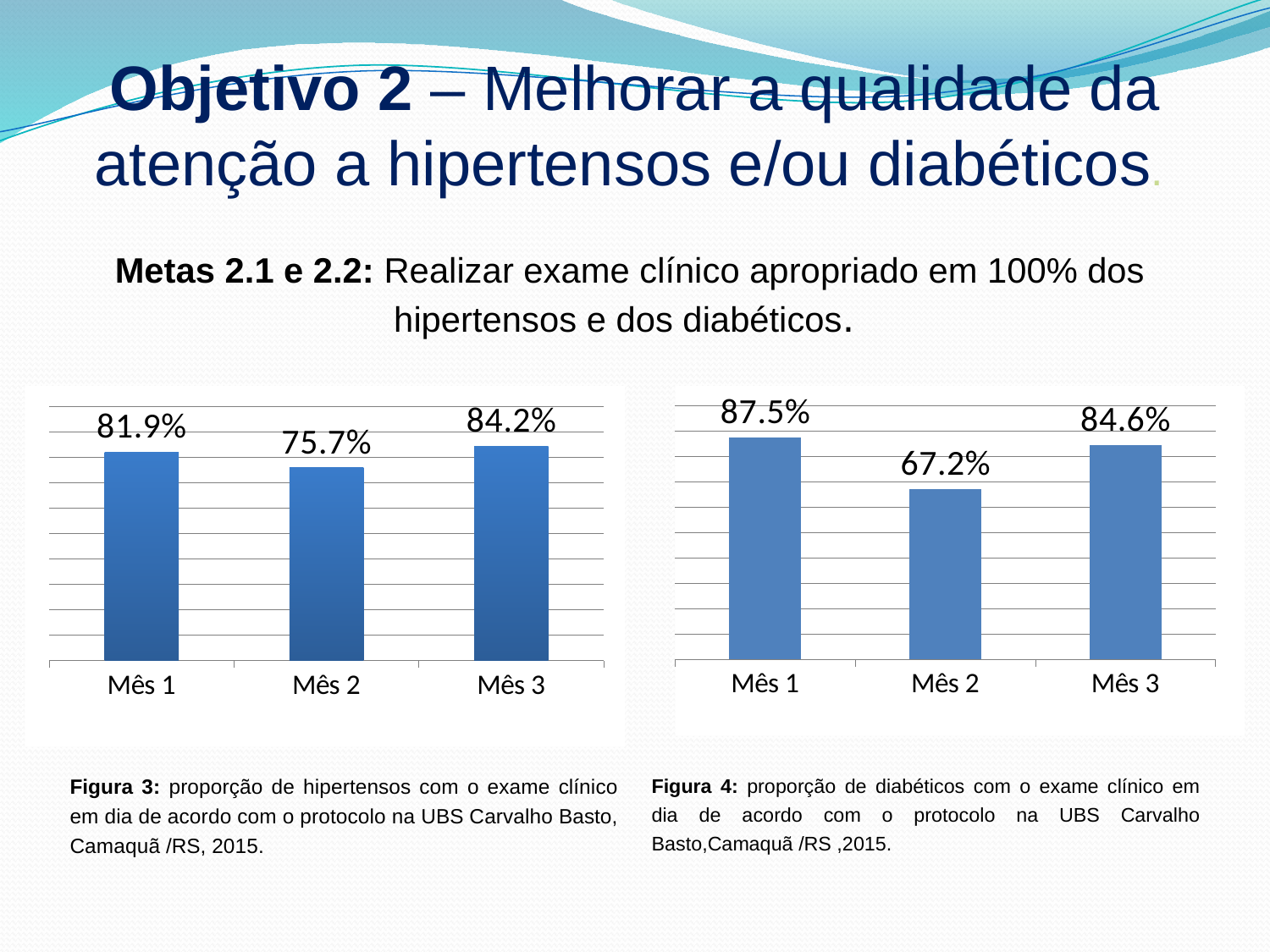
In the left chart (Figura 3, hipertensos), what is the difference between the values for Mês 3 and Mês 2? 8.5% In the right chart (Figura 4, diabéticos), what is the value for Mês 3? 84.6% Which is larger: the Mês 3 value in the left chart (Figura 3) or the Mês 3 value in the right chart (Figura 4)? Figura 4 (84.6%) What type of chart is the right chart (Figura 4, diabéticos)? Bar chart In the right chart (Figura 4, diabéticos), what is the value for Mês 1? 87.5% In the right chart (Figura 4, diabéticos), does the value fall or rise from Mês 1 to Mês 2? Fall In the left chart (Figura 3, hipertensos), what is the value for Mês 2? 75.7% In the right chart (Figura 4, diabéticos), what is the difference between the values for Mês 1 and Mês 2? 20.3% In the left chart (Figura 3, hipertensos), which month has the highest value? Mês 3 In the left chart (Figura 3, hipertensos), what is the value for Mês 1? 81.9% In the right chart (Figura 4, diabéticos), which month has the lowest value? Mês 2 How many bars are shown in the left chart (Figura 3, hipertensos)? 3